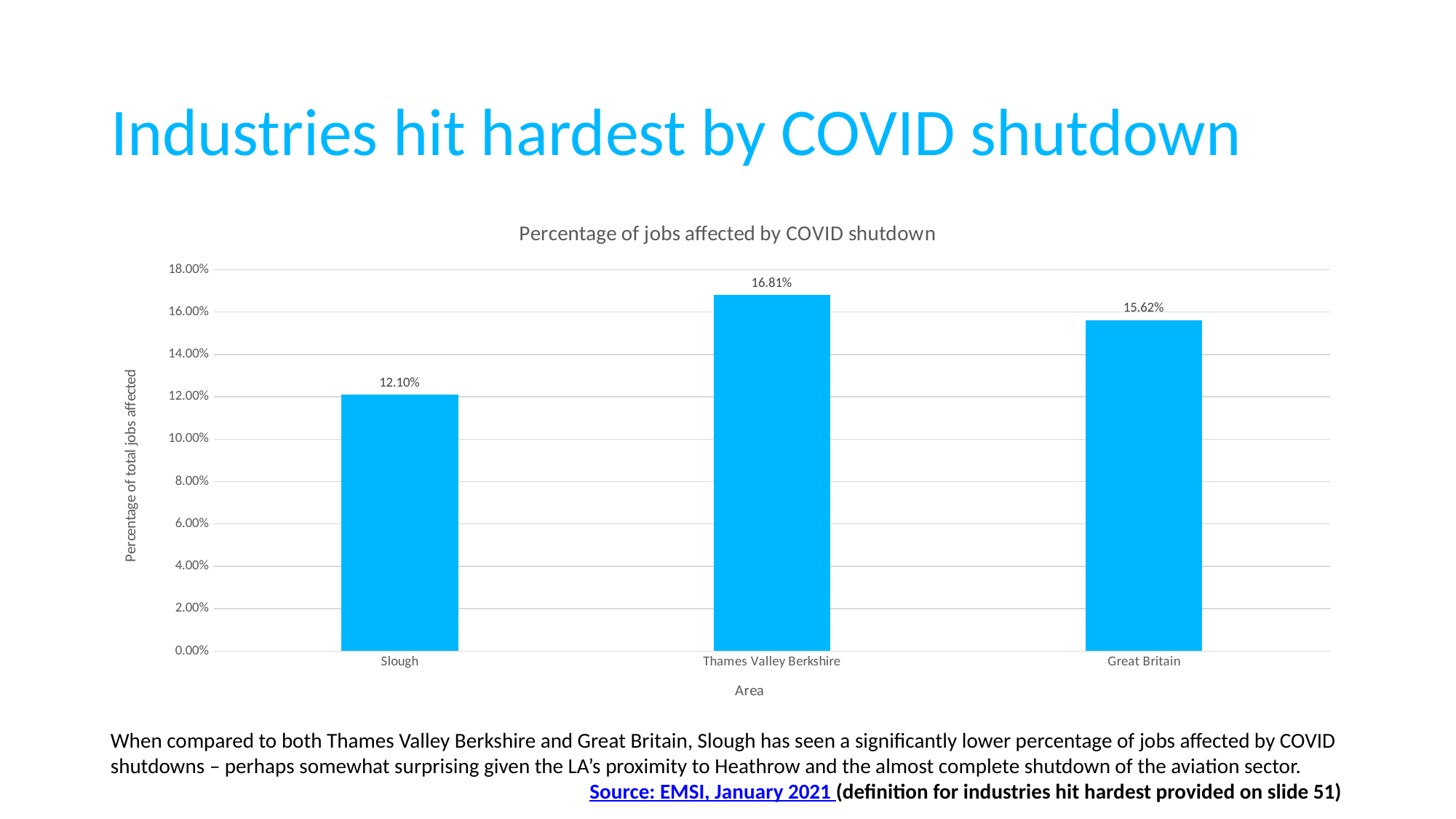
How many areas are shown on the chart? 3 Which area has the lowest percentage of jobs affected by COVID shutdown? Slough Which area has the highest percentage of jobs affected by COVID shutdown? Thames Valley Berkshire What is the title of the chart? Percentage of jobs affected by COVID shutdown What is the difference in percentage points between Thames Valley Berkshire and Slough? 4.71% Which has a higher percentage of jobs affected: Great Britain or Slough? Great Britain What is the percentage of jobs affected by COVID shutdown for Slough? 12.10% What is the percentage of jobs affected by COVID shutdown for Great Britain? 15.62% What is the difference in percentage points between Great Britain and Slough? 3.52% What is the percentage of jobs affected by COVID shutdown for Thames Valley Berkshire? 16.81% Is the value for Slough greater or less than 14.00%? less What kind of chart is shown on the slide? Bar chart